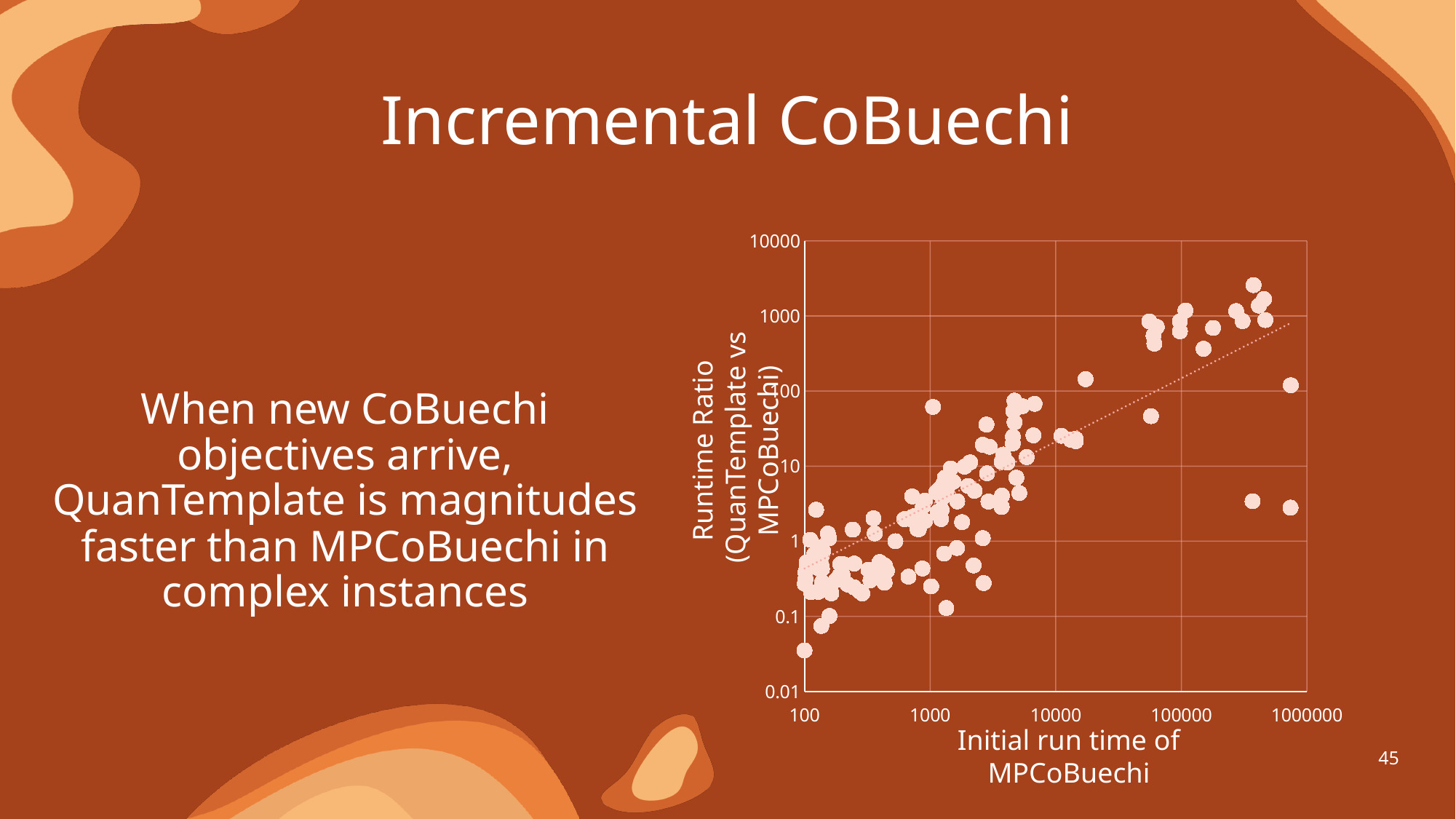
What is the lowest tick value shown on the y axis? 0.01 What is the highest tick value shown on the y axis? 10000 Do the plotted runtime ratios generally rise or fall as the initial run time of MPCoBuechi increases? rise What is the label of the x axis of the chart? Initial run time of MPCoBuechi What is the lowest tick value shown on the x axis? 100 Does the dotted trend line slope upward or downward from left to right? upward What kind of chart is shown on the slide? scatter chart What is the label of the y axis of the chart? Runtime Ratio (QuanTemplate vs MPCoBuechi)